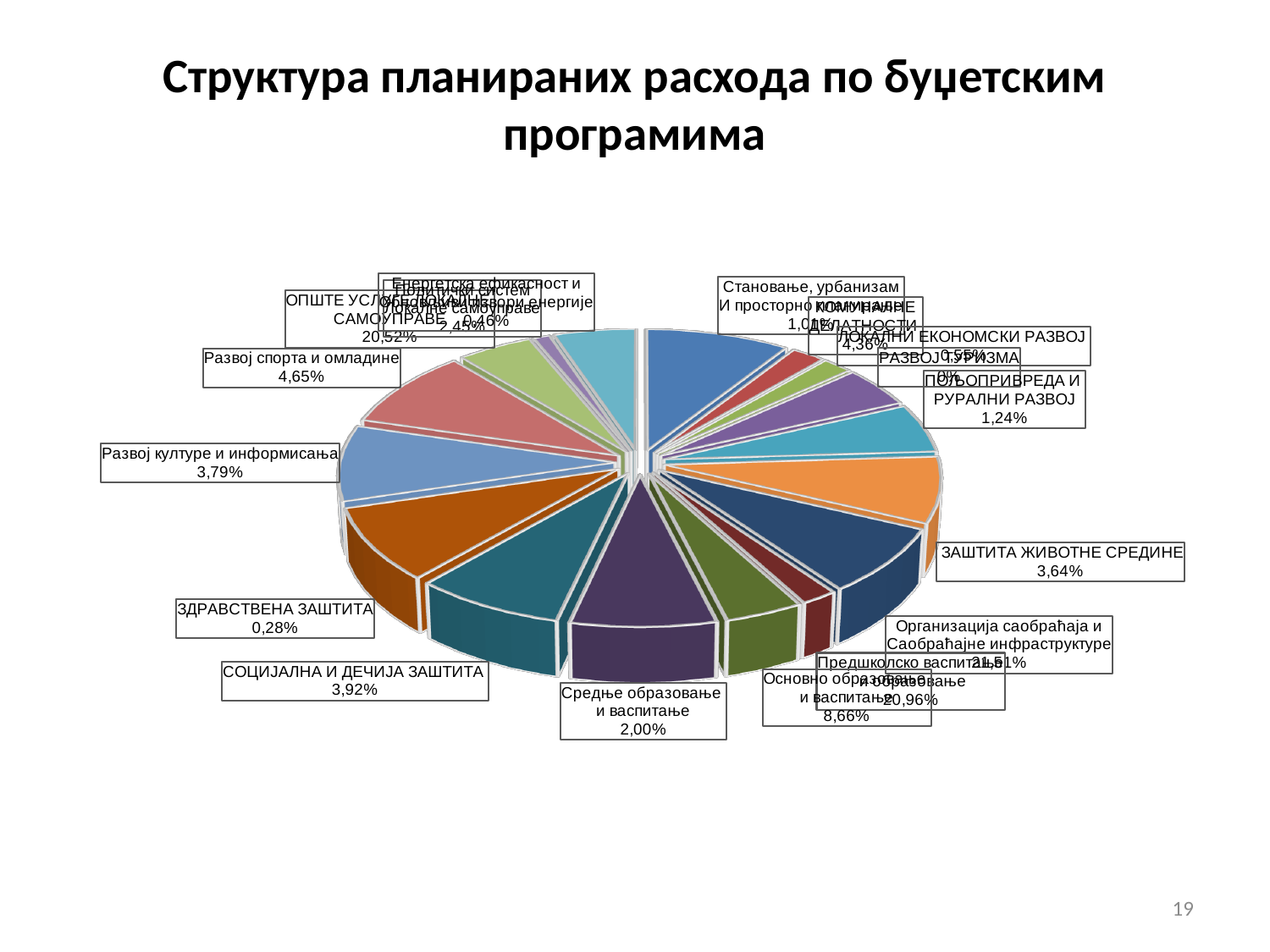
What percentage is shown for Средње образовање и васпитање? 2,00% What percentage is shown for ПОЉОПРИВРЕДА И РУРАЛНИ РАЗВОЈ? 1,24% What kind of chart is shown on the slide? pie chart What percentage is shown for Основно образовање и васпитање? 8,66% What is the difference in percentage points between Развој спорта и омладине and Развој културе и информисања? 0,86 What share is labelled for Развој спорта и омладине? 4,65% What share of planned expenditure goes to ЗАШТИТА ЖИВОТНЕ СРЕДИНЕ? 3,64% What is the difference in percentage points between Основно образовање и васпитање and Средње образовање и васпитање? 6,66 Which is larger: the share for СОЦИЈАЛНА И ДЕЧИЈА ЗАШТИТА or for Развој културе и информисања? СОЦИЈАЛНА И ДЕЧИЈА ЗАШТИТА What is the title of the chart on the slide? Структура планираних расхода по буџетским програмима What percentage is shown for ЗДРАВСТВЕНА ЗАШТИТА? 0,28%